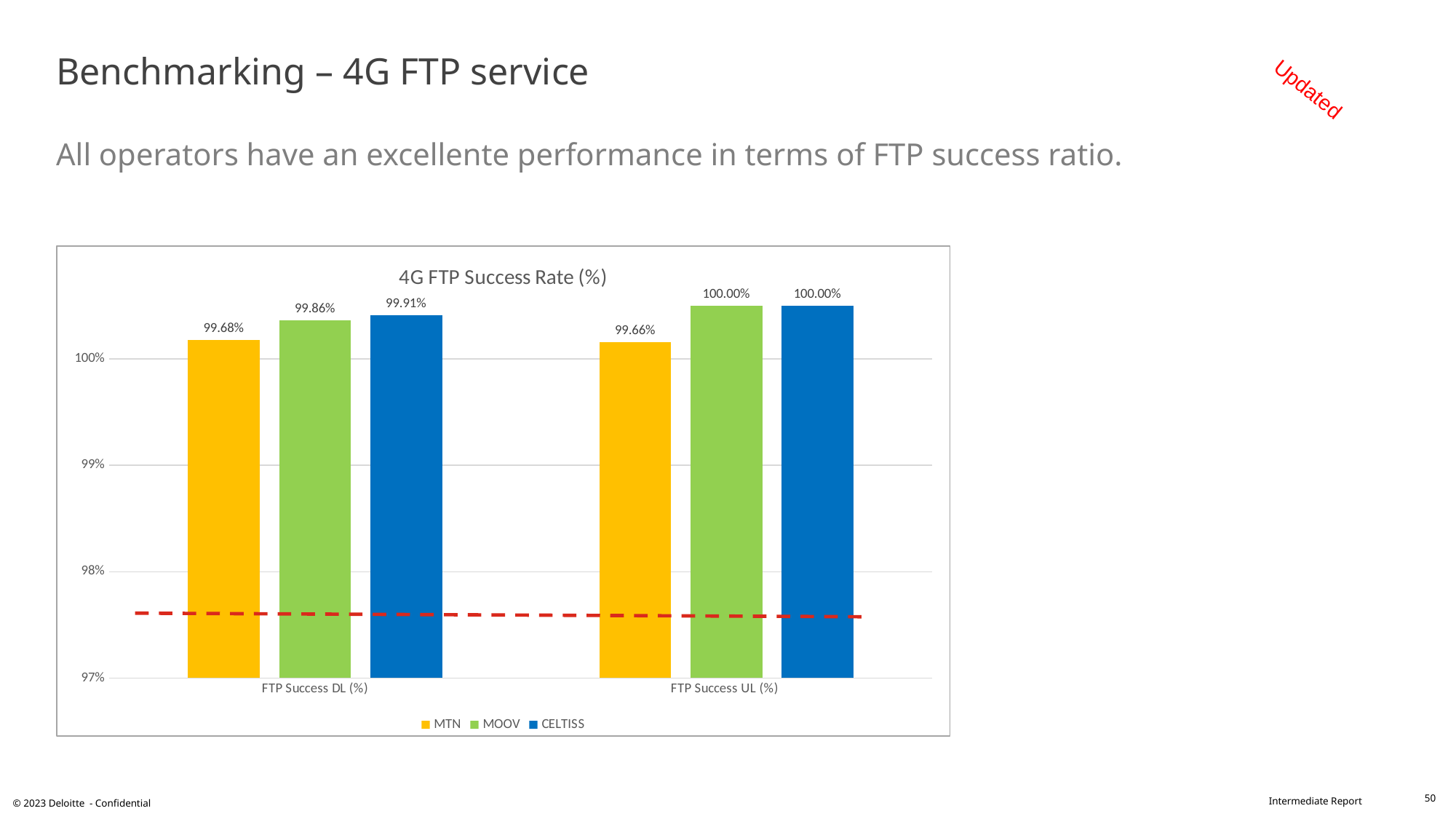
Which operator has the lowest value in the FTP Success UL (%) category? MTN Which operator has the highest value in the FTP Success DL (%) category? CELTISS What is the value for MOOV in the FTP Success DL (%) category? 99.86% What is the value for MTN in the FTP Success UL (%) category? 99.66% How many series does the legend list? 3 What is the difference between the CELTISS and MTN values in the FTP Success DL (%) category? 0.23% What is the value for MTN in the FTP Success DL (%) category? 99.68% What type of chart is shown on the slide? bar chart What is the value for CELTISS in the FTP Success UL (%) category? 100.00% What is the title of the chart? 4G FTP Success Rate (%) How many categories are shown on the x axis? 2 Which is larger for MOOV: the FTP Success DL (%) value or the FTP Success UL (%) value? FTP Success UL (%)